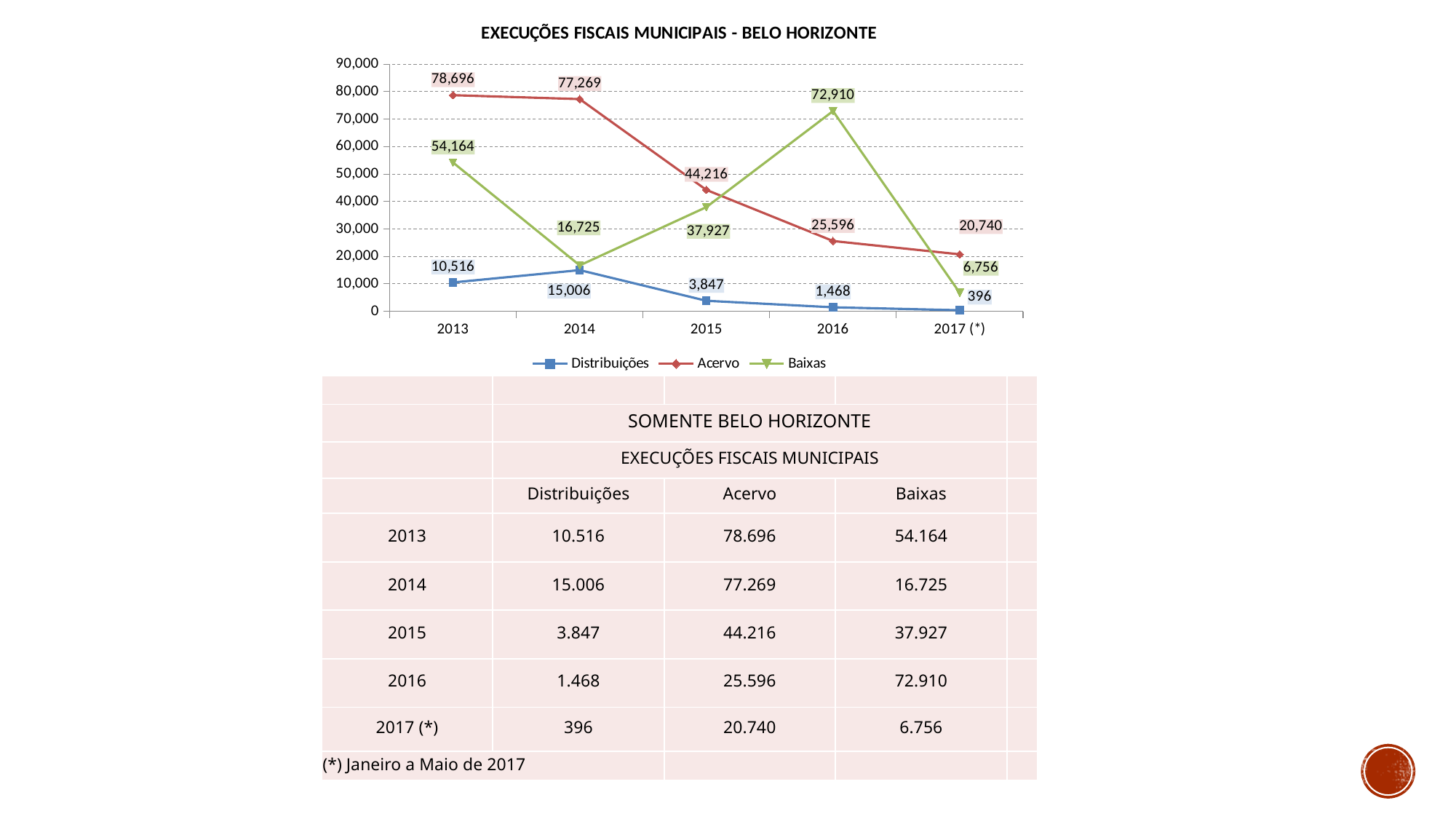
What is the value of Acervo in 2013? 78,696 How many series does the legend list? 3 What is the difference between Distribuições in 2014 and Distribuições in 2013? 4,490 Does the Acervo series rise or fall from 2013 to 2017 (*)? fall In which year is Baixas highest? 2016 Which is larger in 2015, Acervo or Baixas? Acervo What is the difference between Baixas in 2016 and Baixas in 2015? 34,983 What type of chart is shown on the slide? line chart What is the value of Baixas in 2016? 72,910 What is the value of Distribuições in 2015? 3,847 What is the value of Acervo in 2017 (*)? 20,740 In which year is Distribuições lowest? 2017 (*)